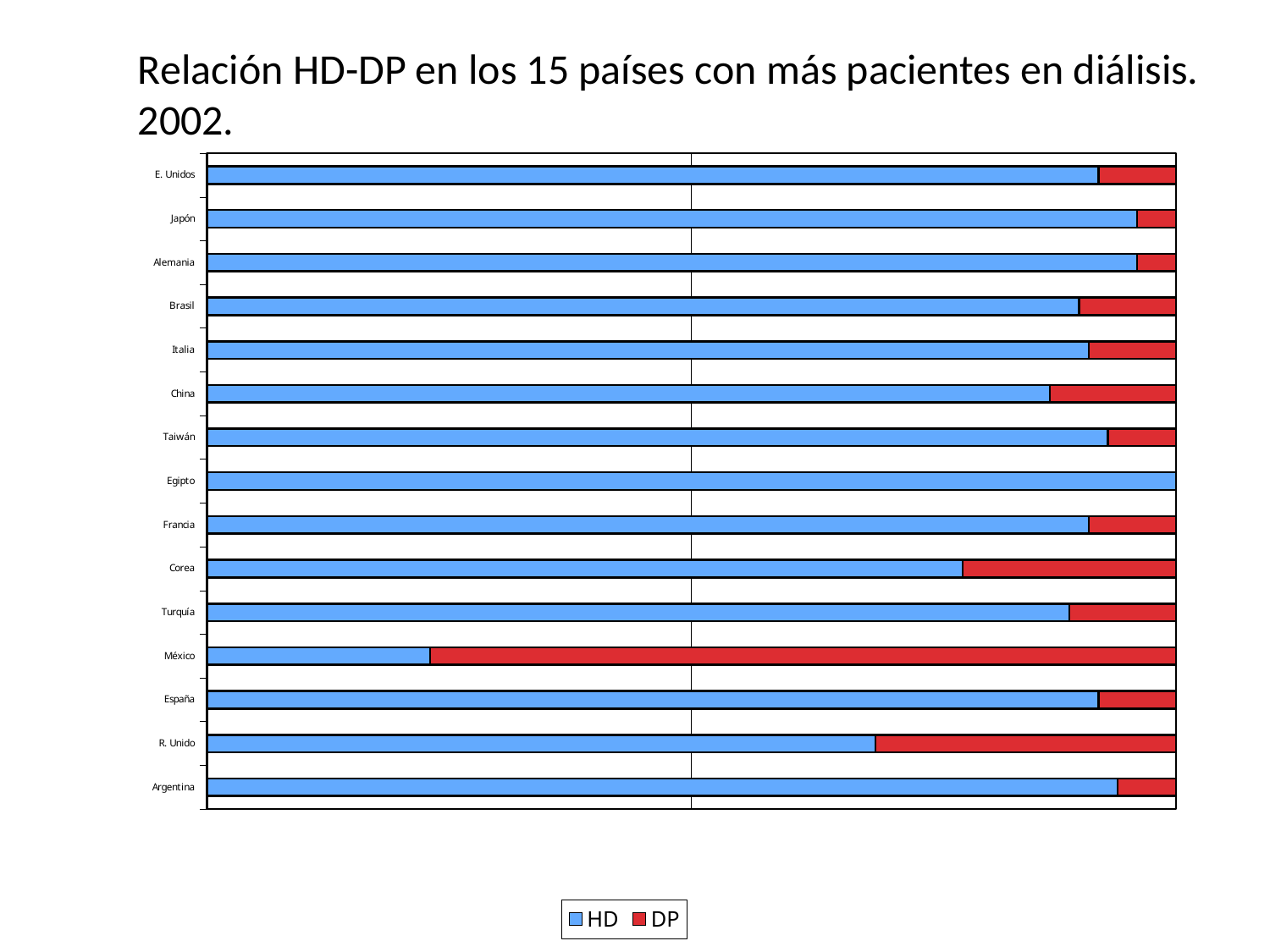
Which country has a larger HD share, Japón or China? Japón Which country's bar is made up entirely of HD, with no visible DP segment? Egipto How many series does the legend list? 2 What are the two series named in the legend? HD and DP Which country has the smallest HD share of its bar? México Which country has a larger DP share, Corea or Argentina? Corea Which country has the largest DP share of its bar? México Which country has a larger DP share, R. Unido or España? R. Unido What kind of chart is shown on the slide? Stacked bar chart Which colour represents DP in the chart? Red How many countries are listed on the chart? 15